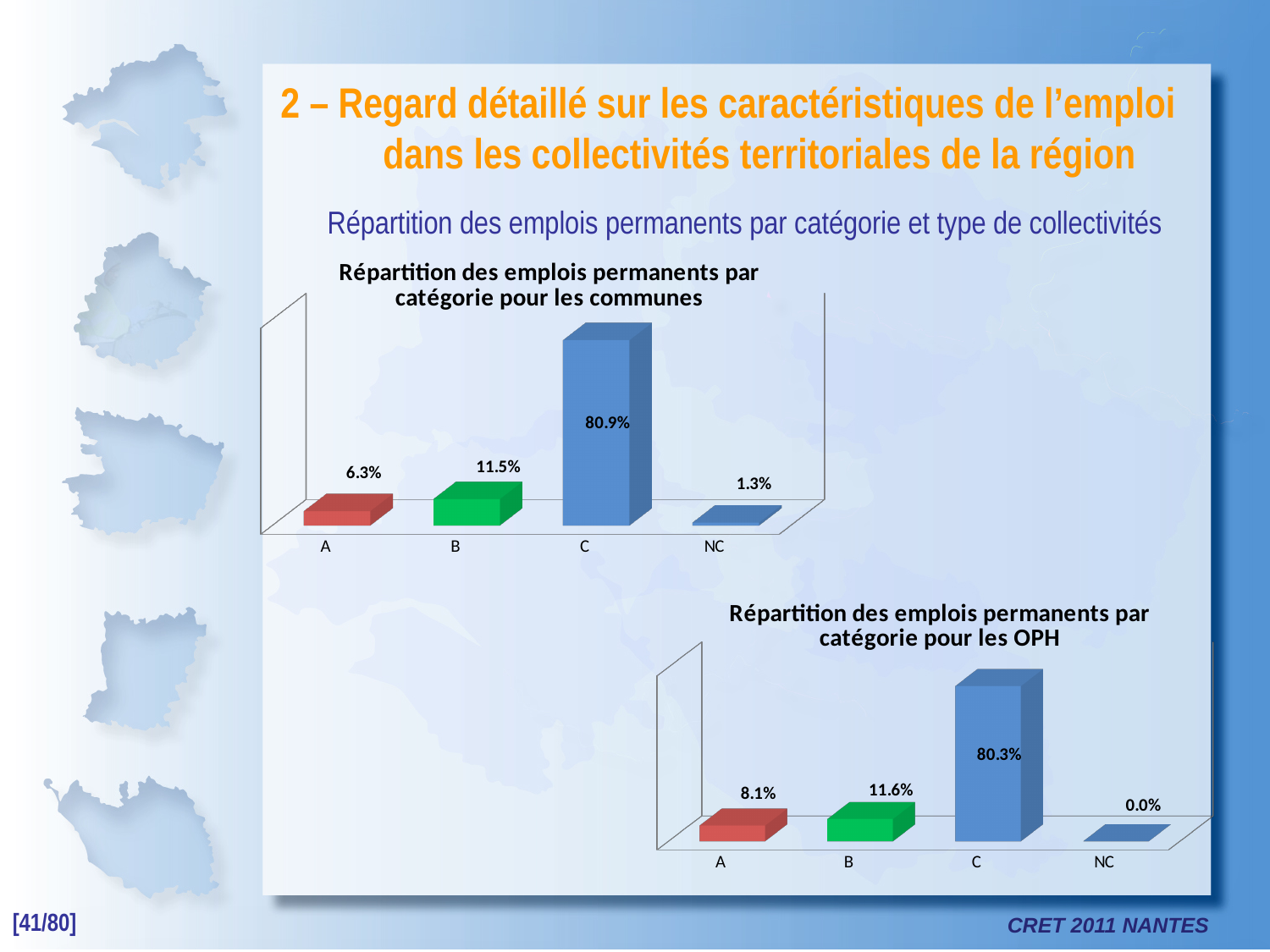
In the chart 'Répartition des emplois permanents par catégorie pour les communes', which is larger, the value for B or the value for NC? B In the chart 'Répartition des emplois permanents par catégorie pour les communes', what is the value for category C? 80.9% In the chart 'Répartition des emplois permanents par catégorie pour les OPH', what is the value for NC? 0.0% In the chart 'Répartition des emplois permanents par catégorie pour les communes', what is the value for category A? 6.3% In the chart 'Répartition des emplois permanents par catégorie pour les communes', what is the difference between the values for B and A? 5.2% What kind of chart is 'Répartition des emplois permanents par catégorie pour les communes'? Bar chart In the chart 'Répartition des emplois permanents par catégorie pour les OPH', which category has the lowest value? NC In the chart 'Répartition des emplois permanents par catégorie pour les communes', which category has the highest value? C How many categories are shown in the chart 'Répartition des emplois permanents par catégorie pour les OPH'? 4 In the chart 'Répartition des emplois permanents par catégorie pour les OPH', what is the difference between the values for C and A? 72.2% In the chart 'Répartition des emplois permanents par catégorie pour les OPH', what colour is the bar for category A? Red In the chart 'Répartition des emplois permanents par catégorie pour les OPH', what is the value for category B? 11.6%